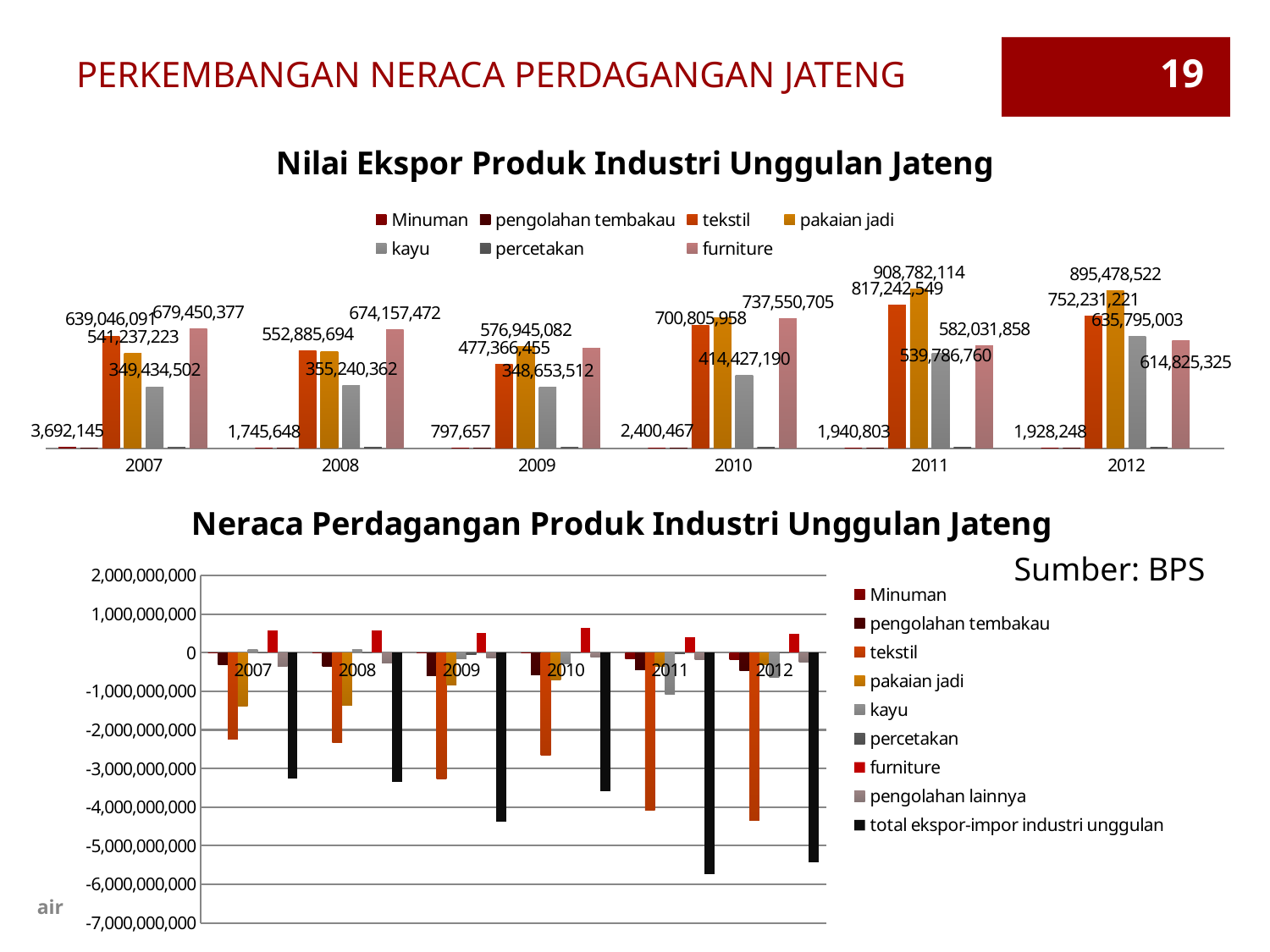
In the chart 'Nilai Ekspor Produk Industri Unggulan Jateng', what is the value for furniture in 2007? 679,450,377 How many years are shown on the x axis of the chart 'Nilai Ekspor Produk Industri Unggulan Jateng'? 6 In the chart 'Nilai Ekspor Produk Industri Unggulan Jateng', what is the difference between the Minuman values in 2007 and 2008? 1,946,497 In the chart 'Nilai Ekspor Produk Industri Unggulan Jateng', in which year is the Minuman value lowest? 2009 In the chart 'Nilai Ekspor Produk Industri Unggulan Jateng', what is the value for kayu in 2012? 635,795,003 In the chart 'Neraca Perdagangan Produk Industri Unggulan Jateng', is the value for total ekspor-impor industri unggulan in 2011 greater or less than -5,000,000,000? less What kind of chart is 'Neraca Perdagangan Produk Industri Unggulan Jateng'? bar chart In the chart 'Nilai Ekspor Produk Industri Unggulan Jateng', what is the value for Minuman in 2007? 3,692,145 How many series does the legend of the chart 'Neraca Perdagangan Produk Industri Unggulan Jateng' list? 9 In the chart 'Nilai Ekspor Produk Industri Unggulan Jateng', in which year is the Minuman value highest? 2007 In the chart 'Nilai Ekspor Produk Industri Unggulan Jateng', which is larger in 2011: tekstil or pakaian jadi? pakaian jadi In the chart 'Nilai Ekspor Produk Industri Unggulan Jateng', what is the value for pakaian jadi in 2011? 908,782,114